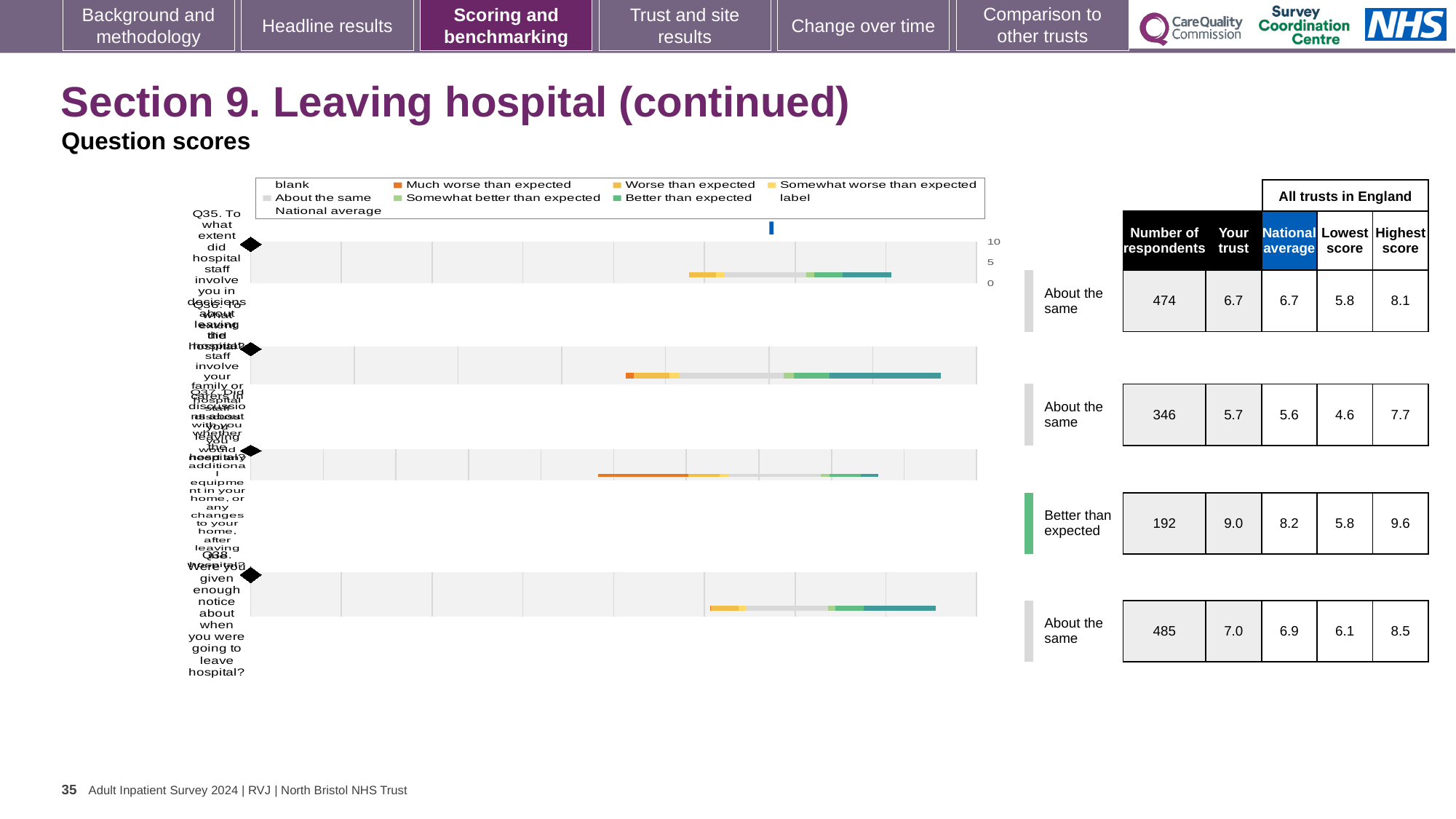
How many question charts are shown on the slide? 4 For the bottom chart (Q38), how many respondents are listed? 485 For the bottom chart (Q38), what is the difference between the highest score and the lowest score across all trusts in England? 2.4 What type of chart is used to show the question scores on this slide? bar chart For the bottom chart (Q38), is the 'Your trust' score or the 'National average' larger? Your trust For the top chart (Q35, involving you in decisions about leaving hospital), what is the 'Your trust' score shown in the table? 6.7 Which of the four charts has the highest 'Your trust' score? the third chart from the top (9.0) For the third chart from the top, how much higher is the 'Your trust' score than the 'National average'? 0.8 For the bottom chart (Q38, given enough notice about leaving hospital), what is the 'Your trust' score? 7.0 For the second chart from the top, what is the lowest score across all trusts in England? 4.6 What benchmark category is shown for the top chart (Q35)? About the same What benchmark category is shown for the third chart from the top? Better than expected